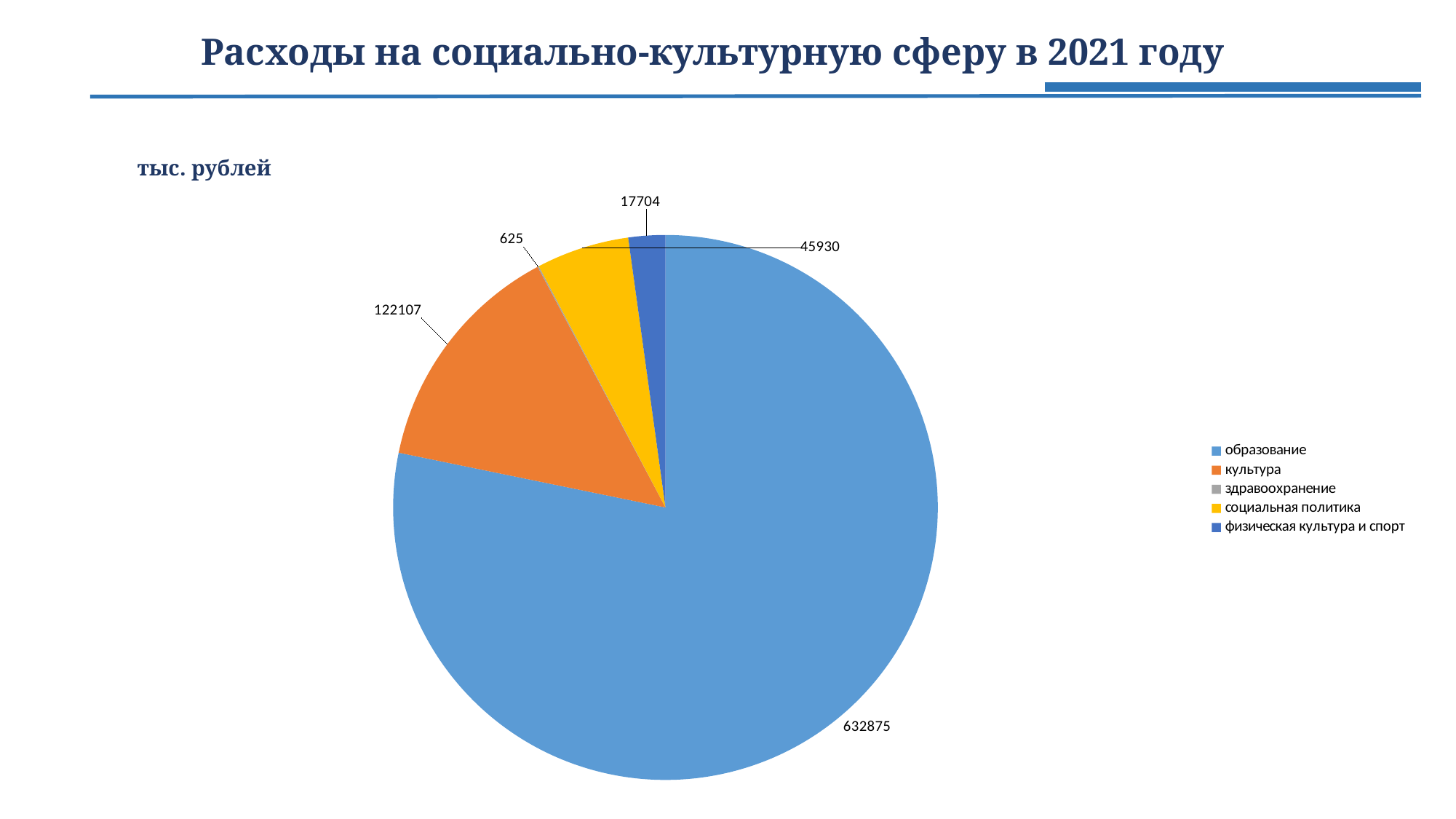
What is the value for социальная политика? 45930 What is the difference between the values for социальная политика and физическая культура и спорт? 28226 Which is larger, культура or социальная политика? культура Which category has the smallest slice? здравоохранение What is the value for здравоохранение? 625 How many categories does the legend list? 5 What is the value for культура? 122107 What is the value for образование? 632875 Which category has the largest slice? образование What is the difference between the values for образование and культура? 510768 What kind of chart is shown on the slide? pie chart What is the value for физическая культура и спорт? 17704